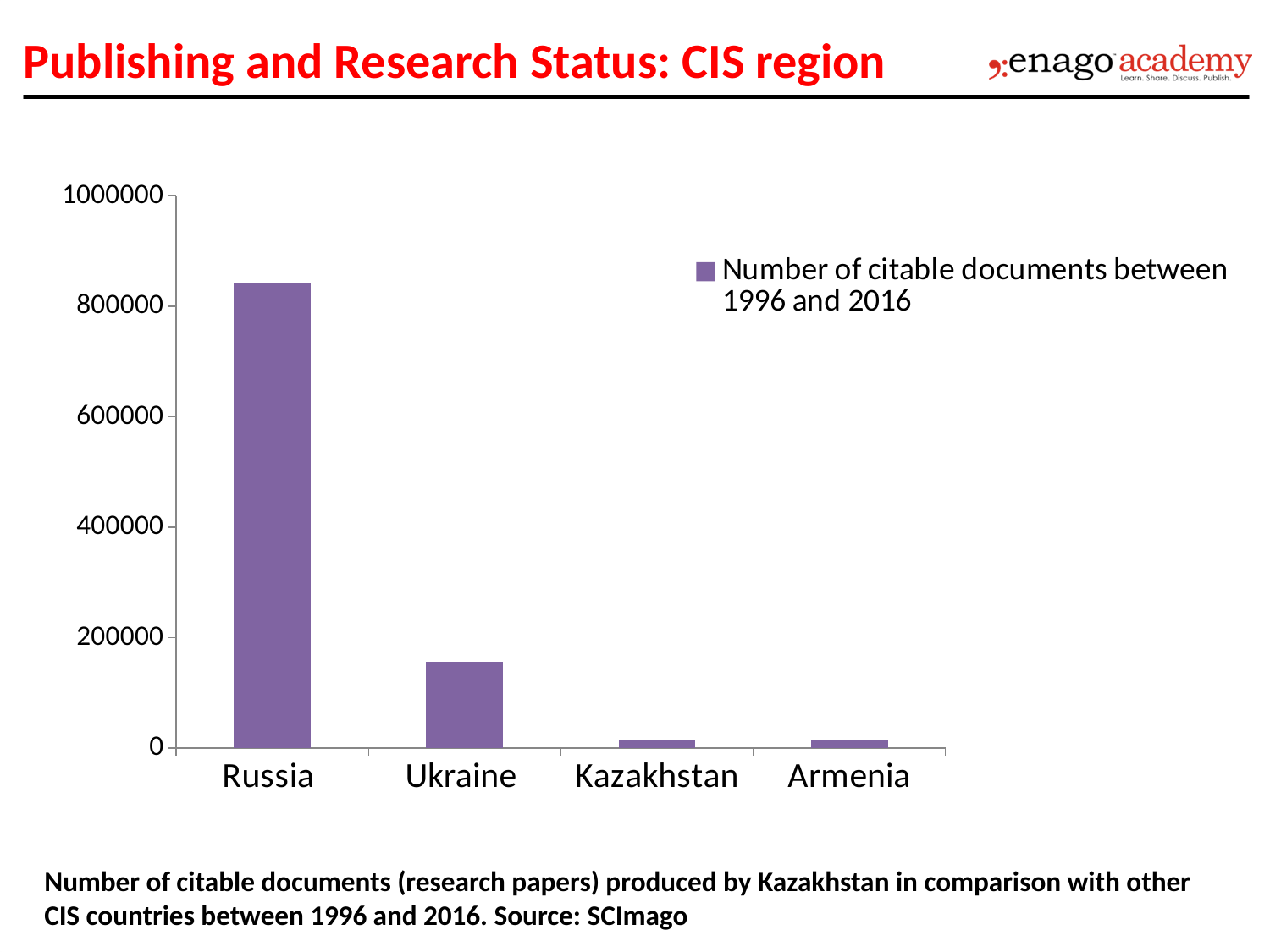
How many series does the chart's legend list? 1 Is the value for Kazakhstan greater or less than 200000? less Is the value for Ukraine greater or less than 200000? less Which has a larger value, Russia or Ukraine? Russia Which has a larger value, Ukraine or Kazakhstan? Ukraine Is the value for Russia greater or less than 800000? greater Which country has the highest number of citable documents in the chart? Russia What source is cited for the chart's data? SCImago What is the legend entry of the series plotted in the chart? Number of citable documents between 1996 and 2016 What kind of chart is shown on the slide? bar chart How many countries are shown on the x axis of the chart? 4